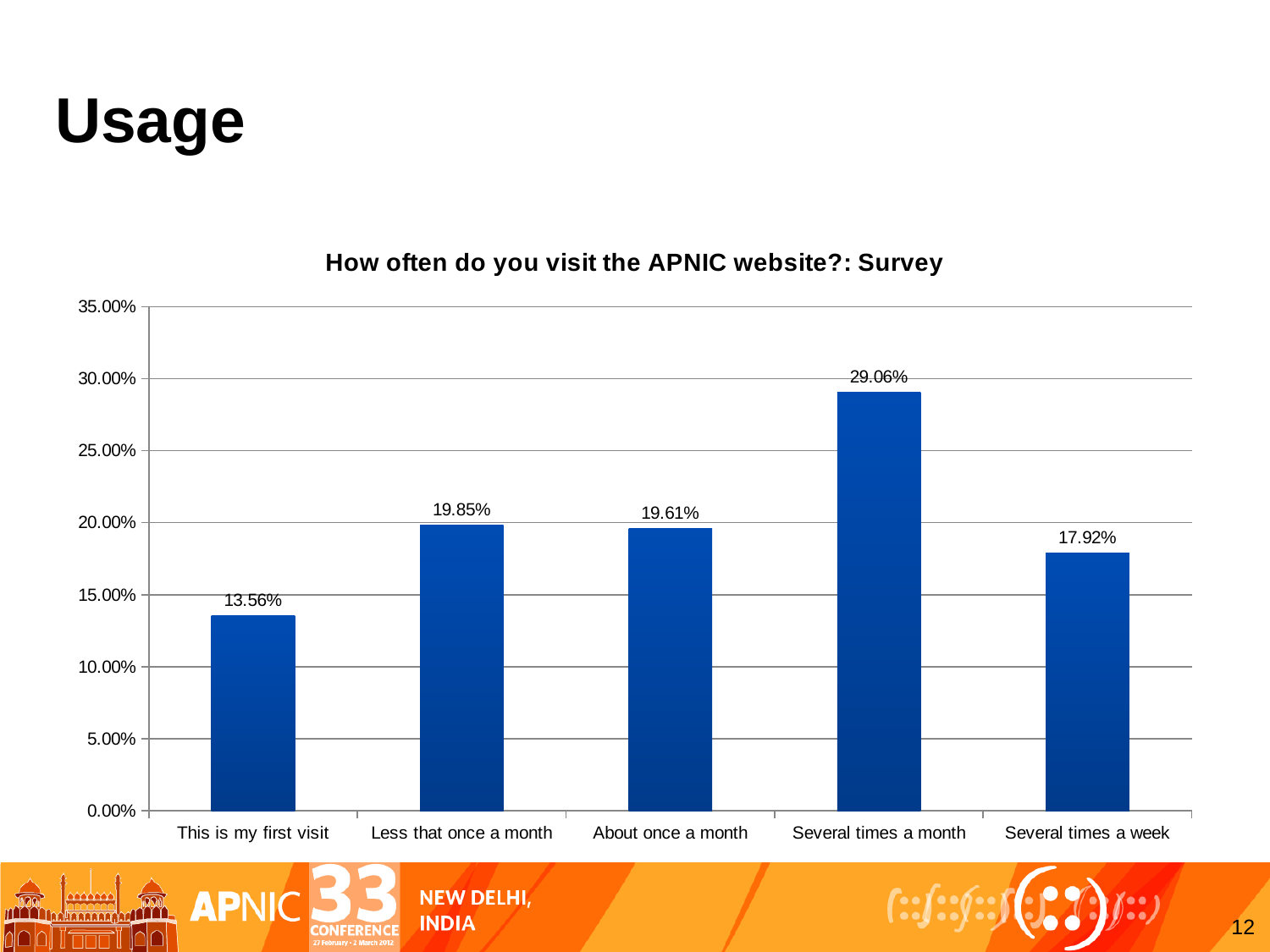
What is the difference between 'Less that once a month' and 'This is my first visit'? 6.29% What kind of chart is shown on the slide? Bar chart What is the difference between 'Several times a month' and 'Several times a week'? 11.14% Which is larger: 'About once a month' or 'Several times a week'? About once a month What is the value for 'Several times a week'? 17.92% What is the title of the chart? How often do you visit the APNIC website?: Survey What percentage of respondents said 'Several times a month'? 29.06% Is the value for 'Several times a month' greater or less than 25.00%? greater How many categories are shown on the x axis? 5 Which category has the highest value? Several times a month Which category has the lowest value? This is my first visit What is the value for 'This is my first visit'? 13.56%